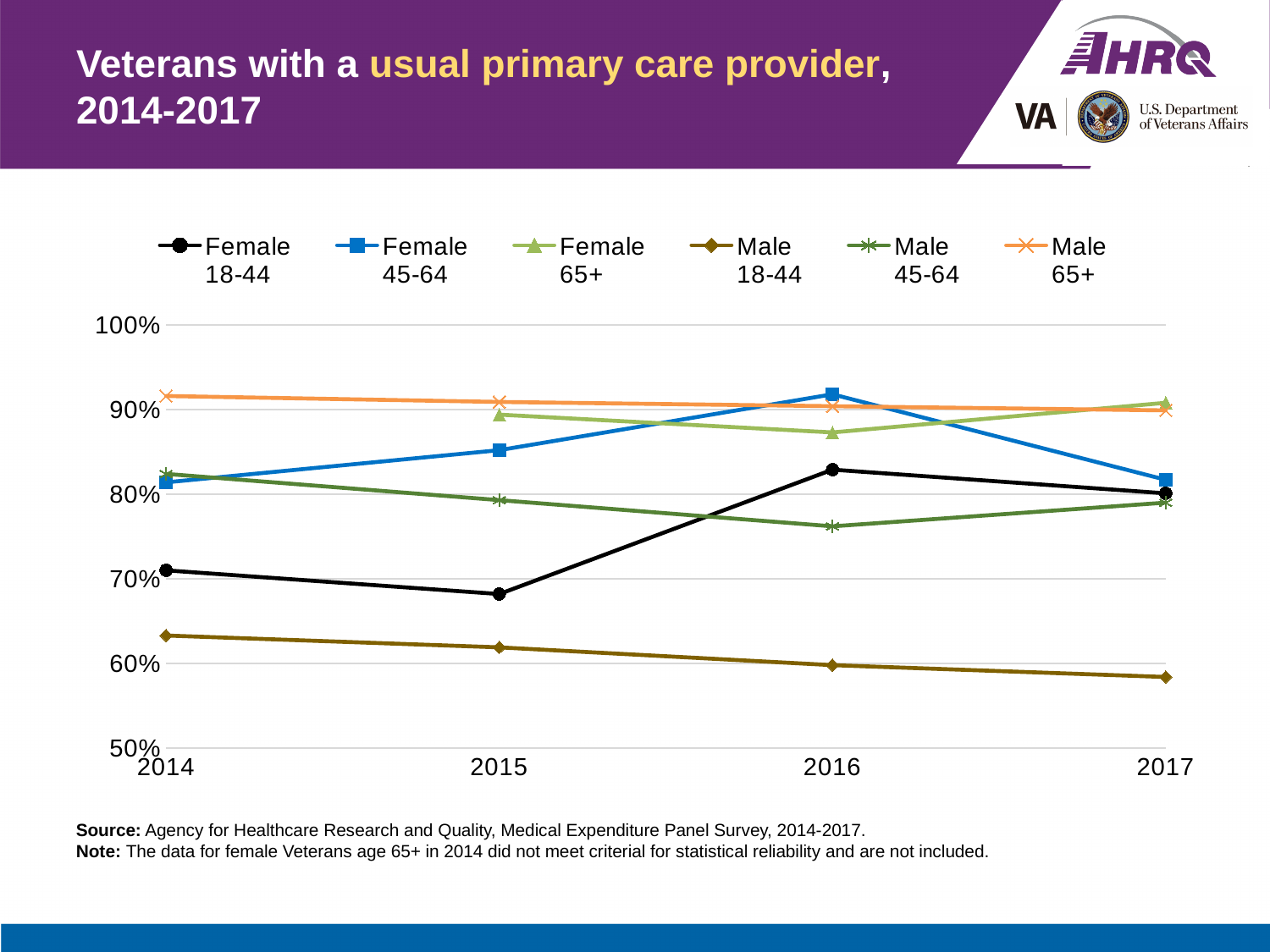
Is the value for Male 45-64 in 2016 greater or less than 80%? less Which series has the highest value in 2016? Female 45-64 Does the Male 18-44 line rise or fall from 2014 to 2017? falls Which series has no data point plotted for 2014? Female 65+ What kind of chart is shown on the slide? line chart Which series has the lowest value in 2017? Male 18-44 Is the value for Female 18-44 in 2016 greater or less than 80%? greater Is the value for Male 18-44 in 2017 greater or less than 60%? less In 2014, which is larger: the value for Female 18-44 or Male 18-44? Female 18-44 How many years are shown on the x axis? 4 How many series does the legend list? 6